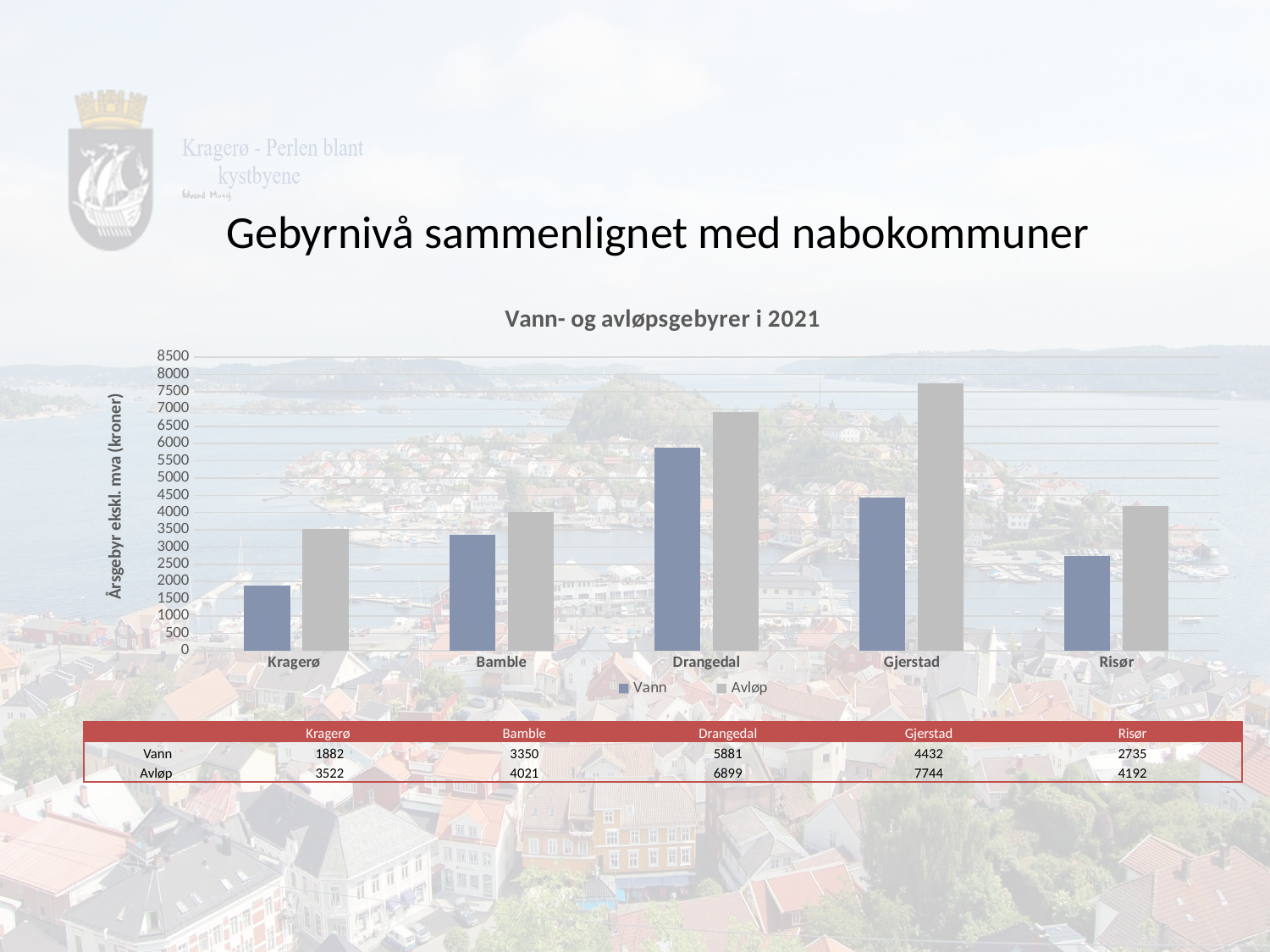
What is the difference between the Avløp and Vann values for Kragerø? 1640 How many municipalities are shown on the x axis? 5 Which municipality has the highest Avløp value? Gjerstad What is the Avløp value for Gjerstad? 7744 How many series does the legend list? 2 Is the Avløp value for Risør greater or less than 4000? greater What is the Vann value for Drangedal? 5881 What kind of chart is shown? bar chart What is the Vann value for Kragerø? 1882 Which municipality has the lowest Vann value? Kragerø Which is larger, the Vann value for Gjerstad or the Vann value for Bamble? Gjerstad What is the title of the chart? Vann- og avløpsgebyrer i 2021